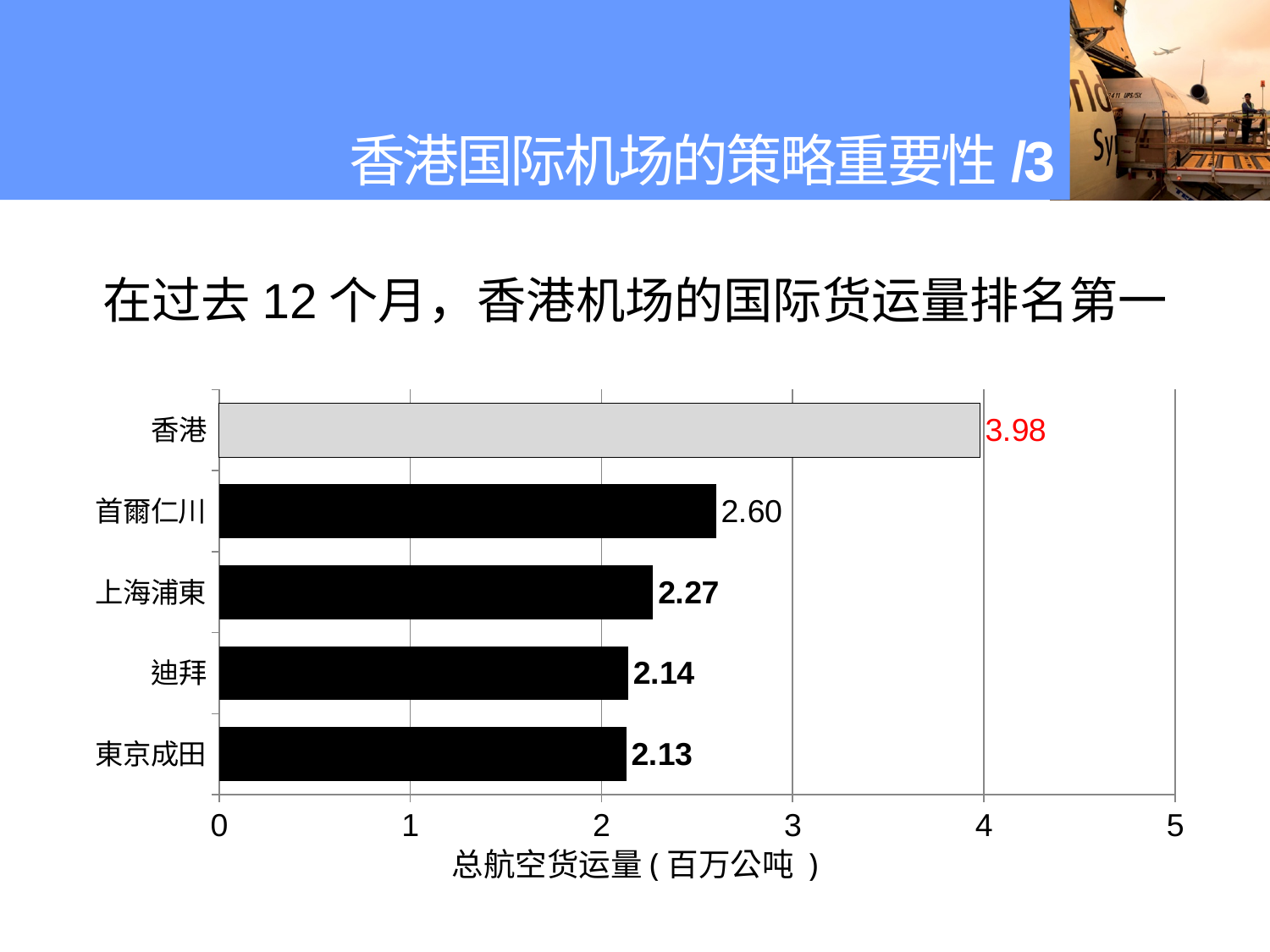
What is the label of the horizontal axis? 总航空货运量 ( 百万公吨 ) What is the value for 東京成田? 2.13 How many airports are shown in the chart? 5 What is the difference between the values for 香港 and 首爾仁川? 1.38 Which airport has the lowest value? 東京成田 Which is larger, the value for 首爾仁川 or the value for 上海浦東? 首爾仁川 What kind of chart is shown on the slide? bar chart What is the value for 香港? 3.98 What is the value for 首爾仁川? 2.60 Which airport has the highest value? 香港 What is the value for 迪拜? 2.14 What is the value for 上海浦東? 2.27